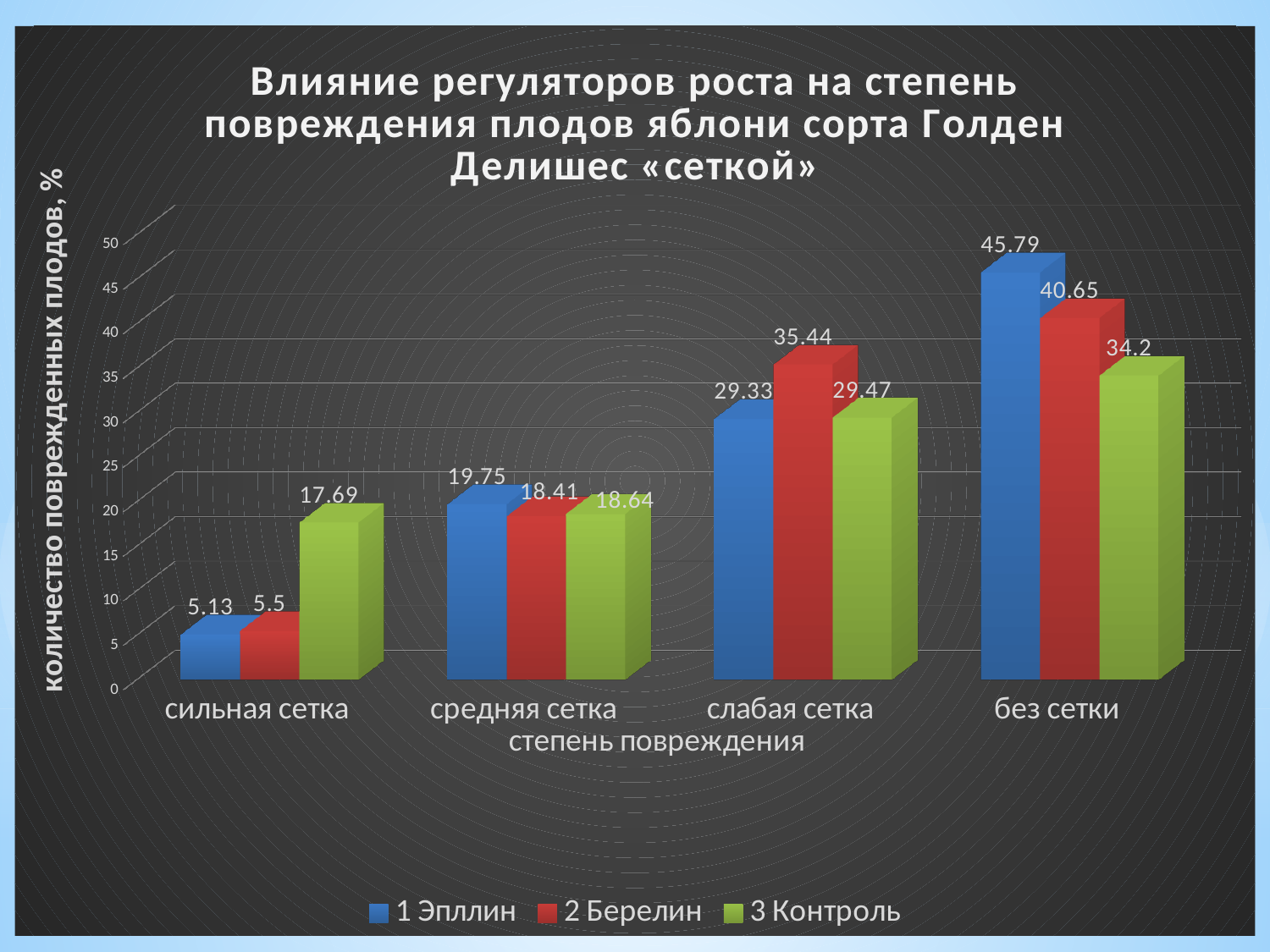
Which category has the highest value for 1 Эпллин? без сетки What is the difference between the 1 Эпллин and 3 Контроль values in the без сетки category? 11.59 What kind of chart is shown on the slide? bar chart In the слабая сетка category, which is larger: 2 Берелин or 3 Контроль? 2 Берелин How many series does the legend list? 3 What is the value for 1 Эпллин in the без сетки category? 45.79 What is the value for 3 Контроль in the сильная сетка category? 17.69 How many categories are shown on the x axis? 4 What is the value for 2 Берелин in the слабая сетка category? 35.44 Do the values for 1 Эпллин rise or fall from сильная сетка to без сетки? rise Which category has the lowest value for 2 Берелин? сильная сетка Is the value for 2 Берелин in the без сетки category greater or less than 40? greater